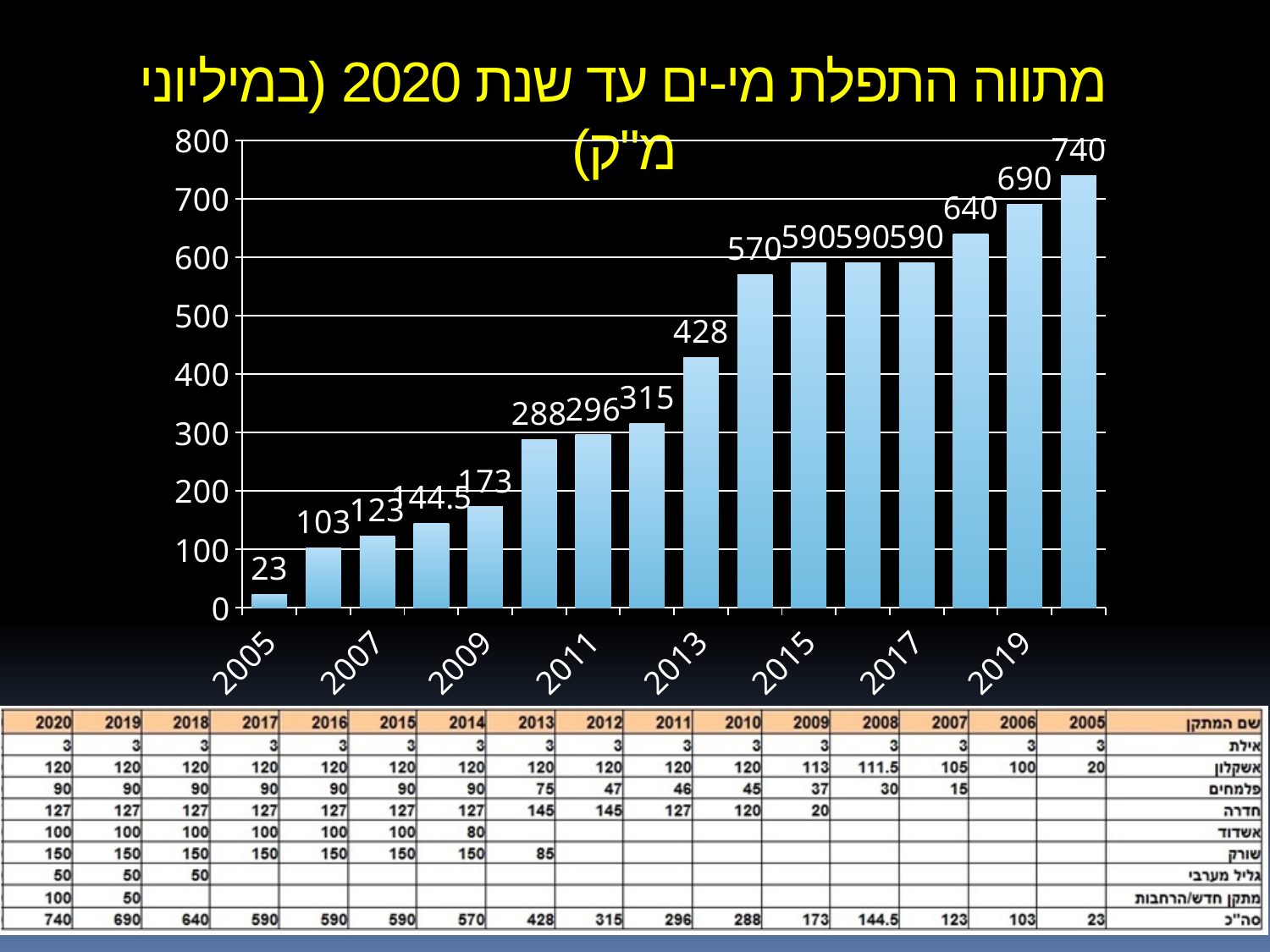
Which year has the lowest value? 2005 What is the value for 2020? 740 What is the difference between the values for 2013 and 2012? 113 What is the difference between the values for 2020 and 2019? 50 What is the value for 2005? 23 Do the values generally rise or fall from 2005 to 2020? rise What is the value for 2013? 428 Which year has the highest value? 2020 Which is larger, the value for 2014 or the value for 2011? 2014 How many bars are plotted in the chart? 16 What type of chart is shown on the slide? bar chart What is the value for 2008? 144.5